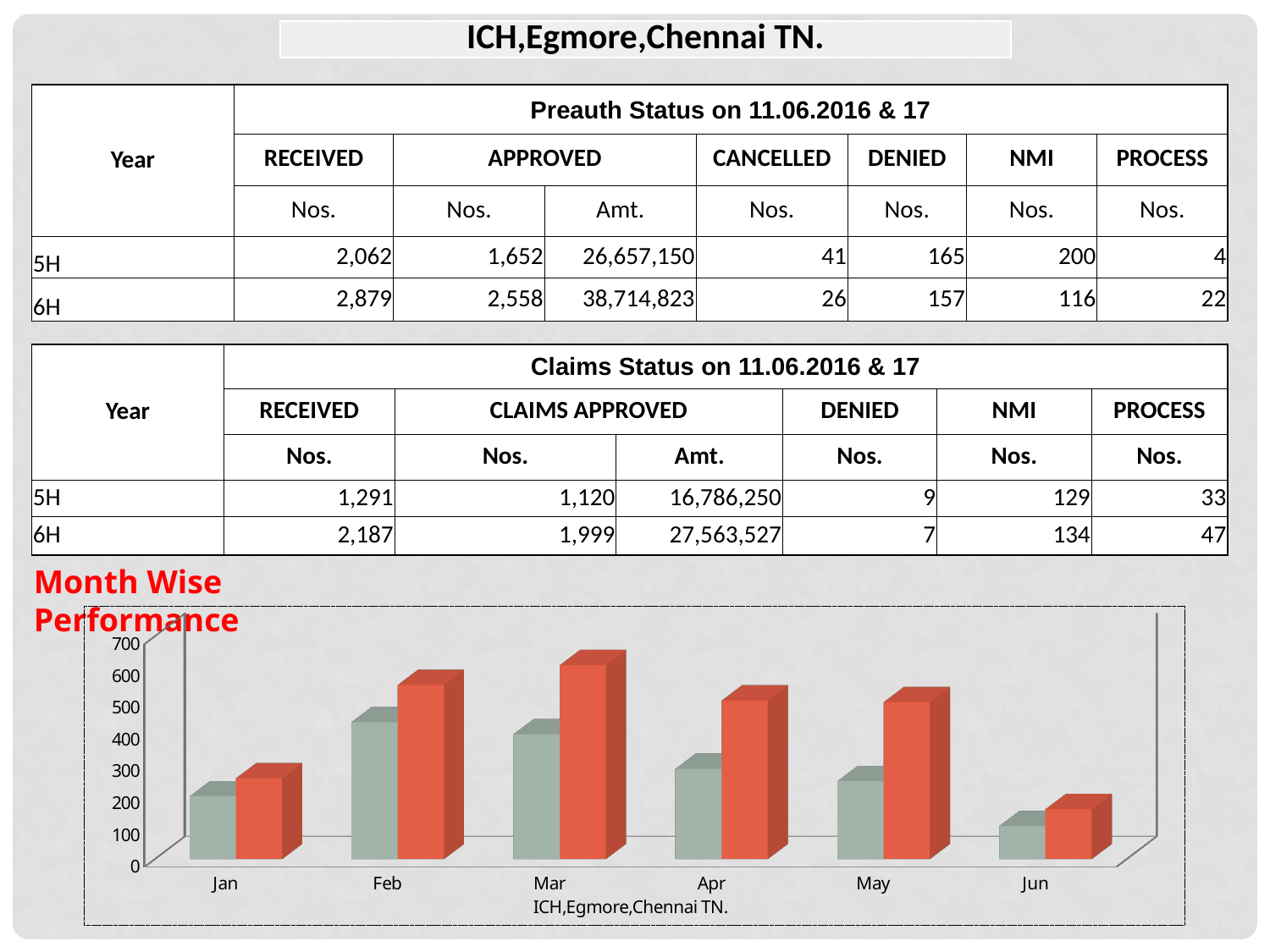
What text appears below the x axis of the Month Wise Performance chart? ICH,Egmore,Chennai TN. In the Month Wise Performance chart, which month has the shortest orange bar? Jun In the Month Wise Performance chart, which month has the shortest grey bar? Jun In the Month Wise Performance chart, is the orange bar for Jan greater or less than 300? less What kind of chart is shown under the heading "Month Wise Performance"? bar chart In the Month Wise Performance chart, do the orange bars rise or fall from Mar to Jun? fall How many bars are plotted for each month in the Month Wise Performance chart? 2 In the Month Wise Performance chart, is the grey bar for Jun greater or less than 200? less In the Month Wise Performance chart, is the orange bar for Mar larger or smaller than the orange bar for Apr? larger In the Month Wise Performance chart, is the orange bar for Feb greater or less than 500? greater In the Month Wise Performance chart, which month has the tallest orange bar? Mar How many months are shown on the x axis of the Month Wise Performance chart? 6